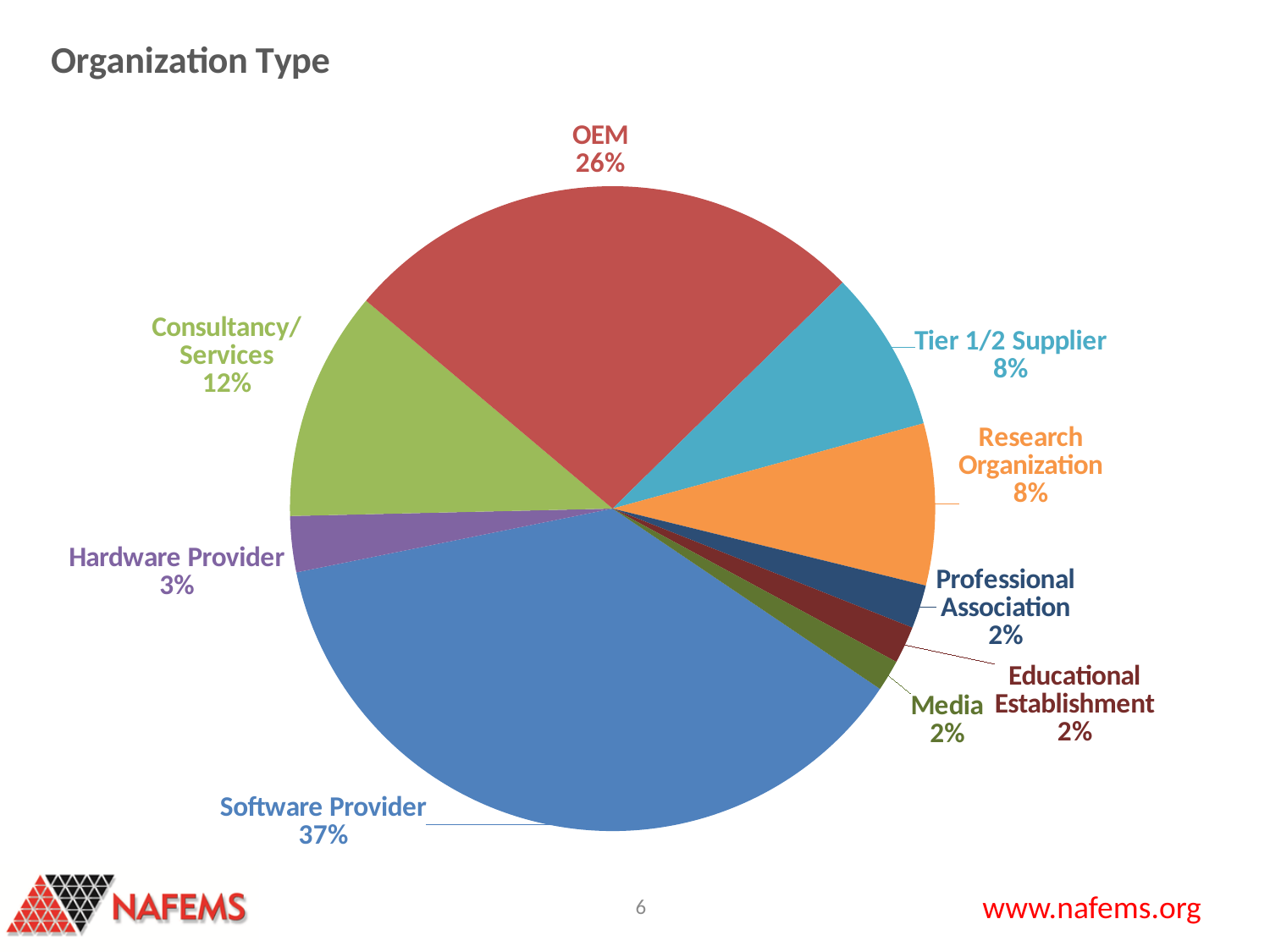
What share of the pie does Software Provider represent? 37% What is the value shown for Research Organization? 8% Which is larger, the share for Tier 1/2 Supplier or the share for Hardware Provider? Tier 1/2 Supplier What is the title of the chart? Organization Type How many categories (slices) does the pie chart have? 9 What is the combined share of Media, Educational Establishment and Professional Association? 6% What is the value shown for OEM? 26% What type of chart is shown on the slide? Pie chart Which organization type has the largest share of the pie? Software Provider What is the value shown for Consultancy/Services? 12% What is the value shown for Hardware Provider? 3% What is the difference between the Software Provider share and the OEM share? 11%